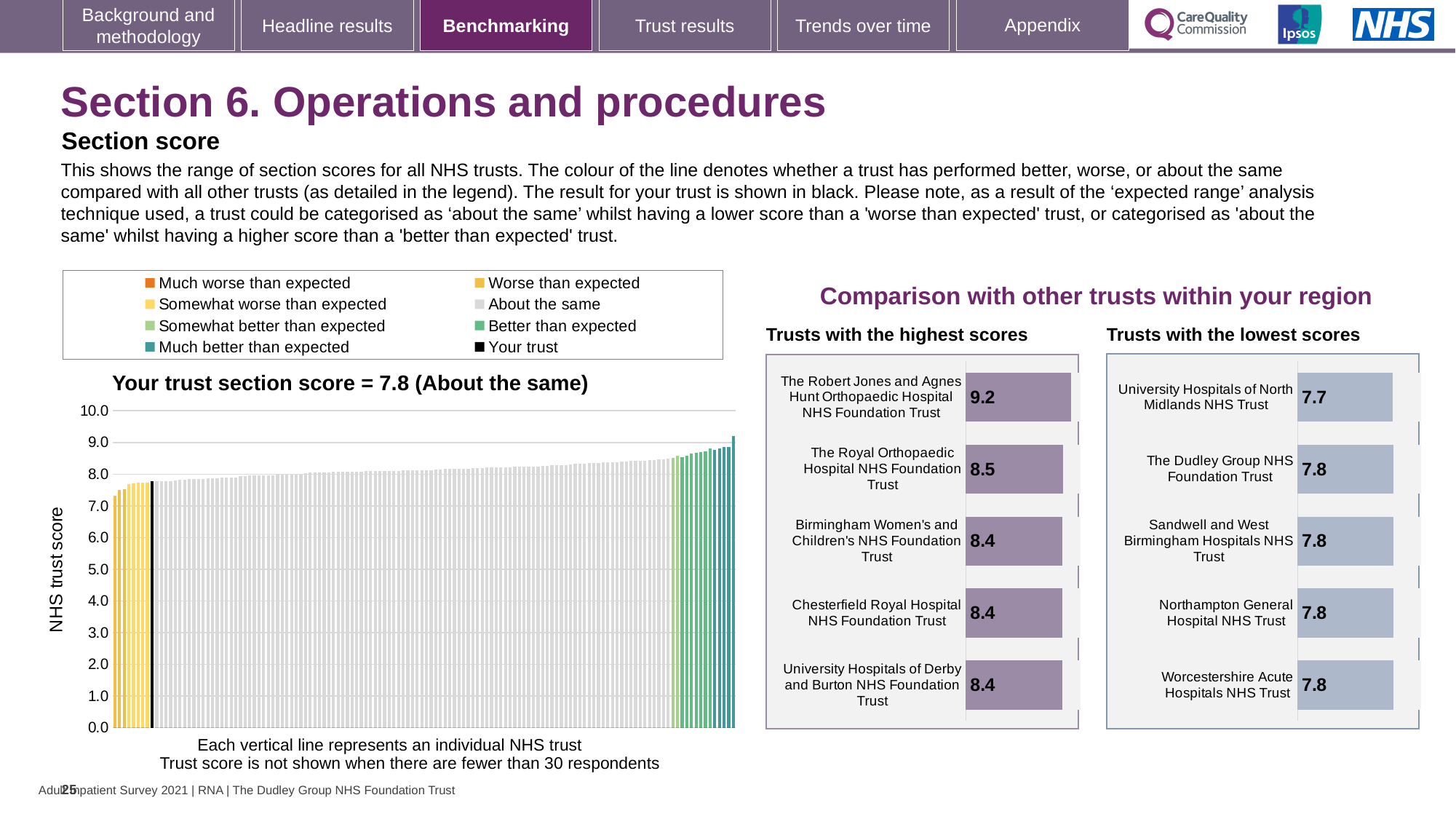
In the 'Your trust section score' chart, what is the label on the vertical axis? NHS trust score How many trusts are shown in the 'Trusts with the highest scores' chart? 5 In the 'Trusts with the lowest scores' chart, what is the score for Worcestershire Acute Hospitals NHS Trust? 7.8 What kind of chart is the 'Your trust section score' chart on the left of the slide? bar chart In the 'Trusts with the lowest scores' chart, which trust has the lowest score? University Hospitals of North Midlands NHS Trust In the 'Trusts with the highest scores' chart, what is the difference between the scores of The Robert Jones and Agnes Hunt Orthopaedic Hospital NHS Foundation Trust and The Royal Orthopaedic Hospital NHS Foundation Trust? 0.7 In the 'Trusts with the highest scores' chart, what is the score for The Royal Orthopaedic Hospital NHS Foundation Trust? 8.5 How many entries does the legend above the 'Your trust section score' chart list? 8 In the 'Trusts with the highest scores' chart, which has the larger score: The Royal Orthopaedic Hospital NHS Foundation Trust or Chesterfield Royal Hospital NHS Foundation Trust? The Royal Orthopaedic Hospital NHS Foundation Trust In the 'Trusts with the highest scores' chart, which trust has the highest score? The Robert Jones and Agnes Hunt Orthopaedic Hospital NHS Foundation Trust In the 'Trusts with the lowest scores' chart, what is the difference between the scores of The Dudley Group NHS Foundation Trust and University Hospitals of North Midlands NHS Trust? 0.1 In the 'Your trust section score' chart, what is the section score for your trust? 7.8